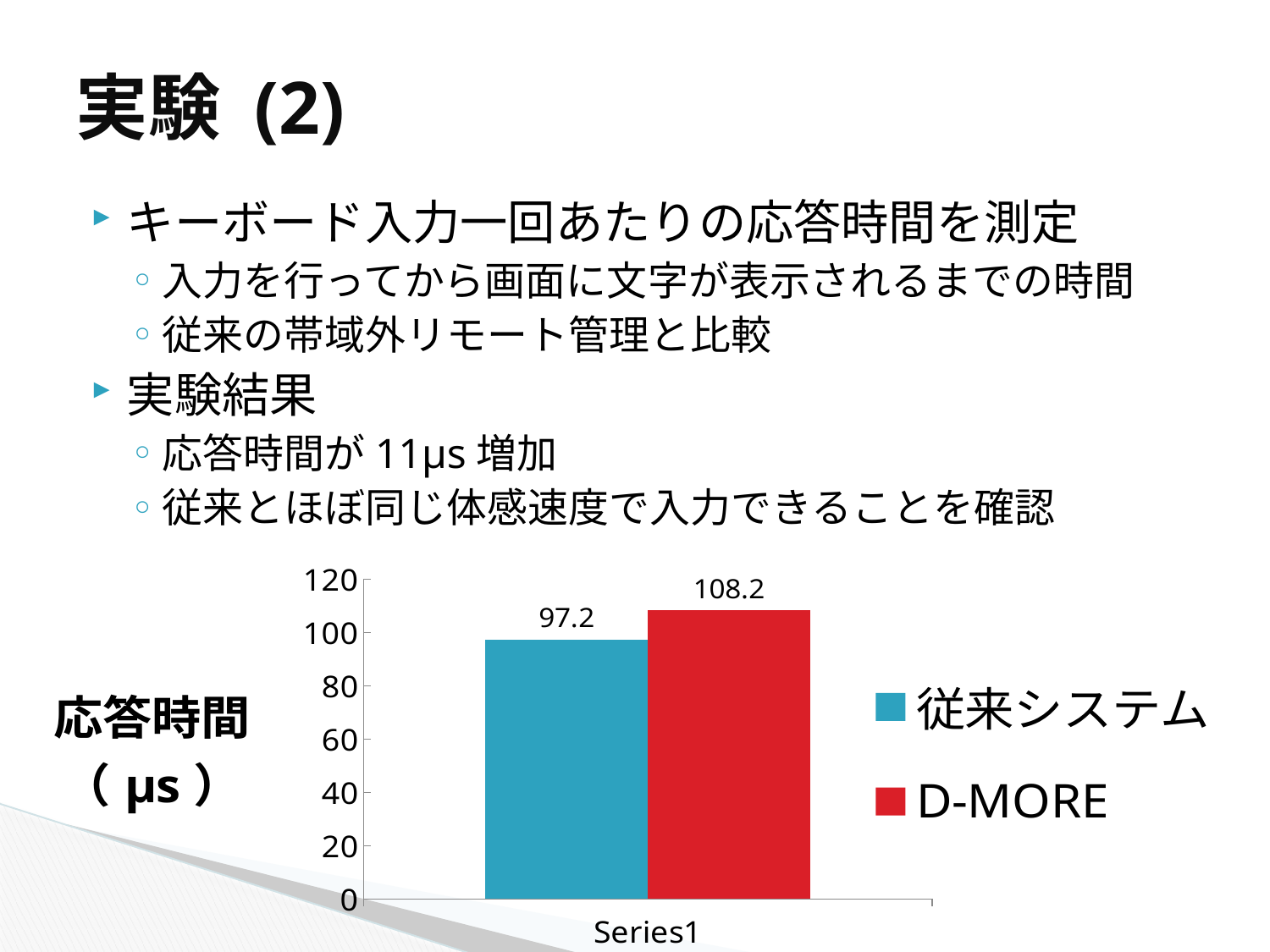
Which series has the higher value, 従来システム or D-MORE? D-MORE What colour is the bar for D-MORE? red Is the value for 従来システム greater or less than 100? less What is the value for D-MORE? 108.2 What is the category label shown on the x axis? Series1 What is the maximum value shown on the y axis? 120 Which series has the lower value? 従来システム Is the value for D-MORE greater or less than 100? greater What is the value for 従来システム? 97.2 How many series does the legend list? 2 What kind of chart is shown on the slide? bar chart What is the difference between the D-MORE value and the 従来システム value? 11